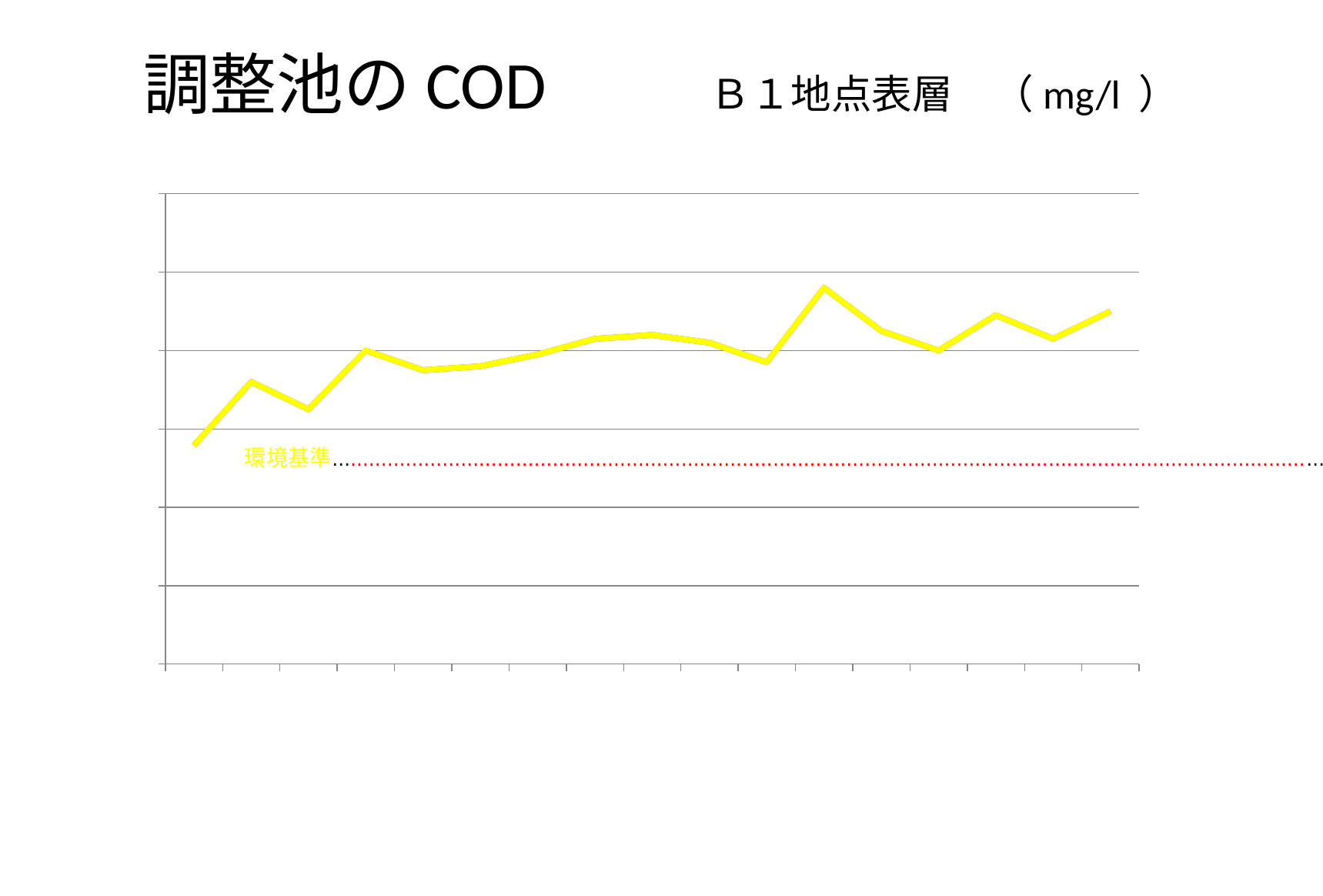
What kind of chart is shown on the slide? line chart Do the COD values generally rise or fall from left to right along the x axis? rise How many data points are plotted on the yellow line? 17 Are the plotted COD values above or below the red dotted 環境基準 line? above What is the title of the chart on the slide? 調整池のCOD What unit is given for the COD values in the chart? mg/l Is the last plotted value higher or lower than the first plotted value? higher